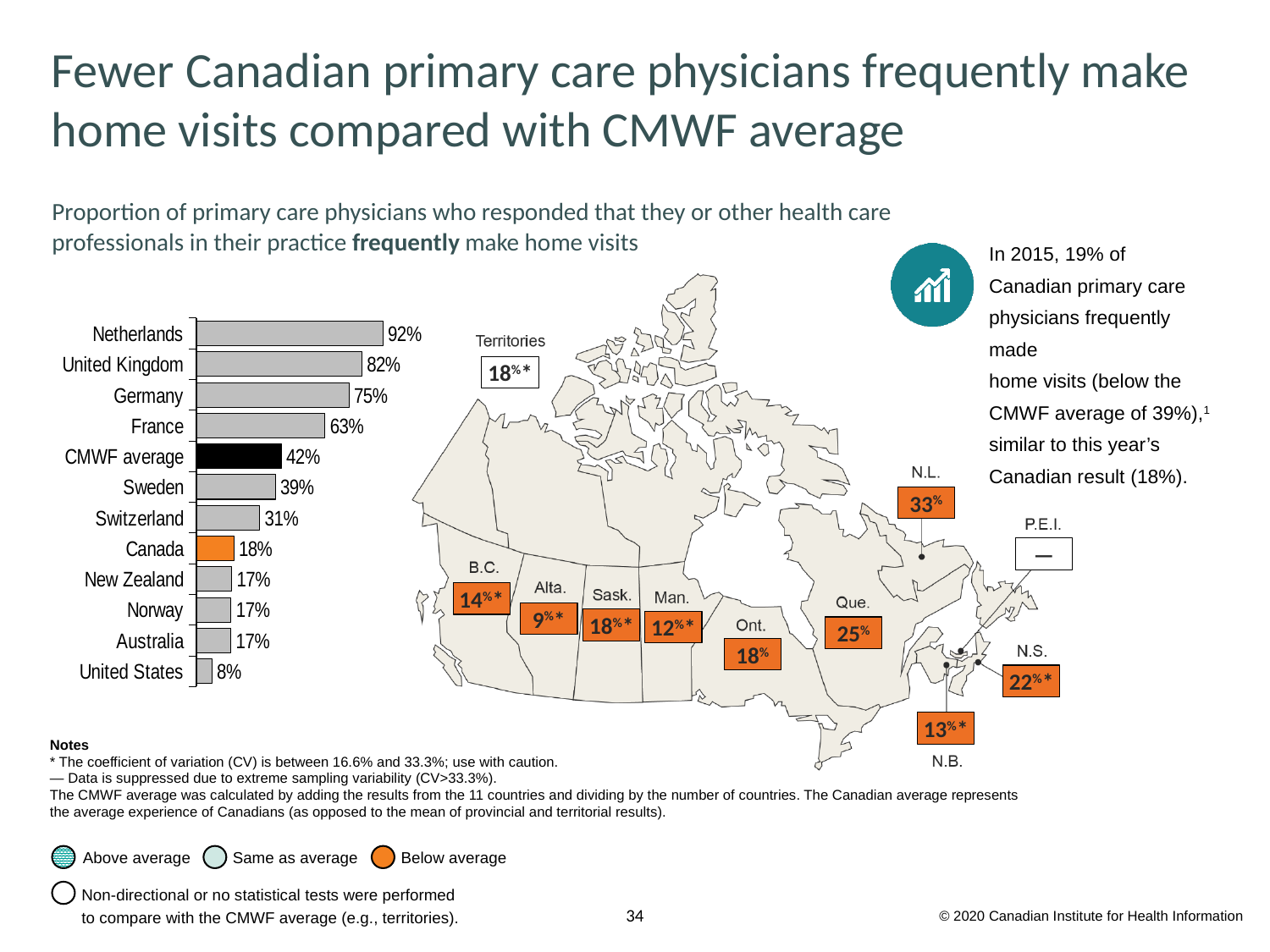
In the bar chart, which country has the highest proportion of physicians who frequently make home visits? Netherlands On the map of Canada, what is the value shown for Quebec (Que.)? 25% How many categories (countries plus the CMWF average) are shown in the bar chart? 12 In the bar chart, what is the value for the CMWF average? 42% In the bar chart, which has a higher value, Germany or France? Germany In the bar chart, which country has the lowest proportion of physicians who frequently make home visits? United States In the bar chart, do the values increase or decrease going from the top bar to the bottom bar? decrease In the bar chart, what is the value for the Netherlands? 92% What type of chart is used to show the proportion of primary care physicians who frequently make home visits by country? bar chart In the bar chart, what is the difference in percentage points between the Netherlands and Canada? 74 percentage points In the bar chart, what is the value for Canada? 18% In the bar chart, which bar is coloured orange? Canada